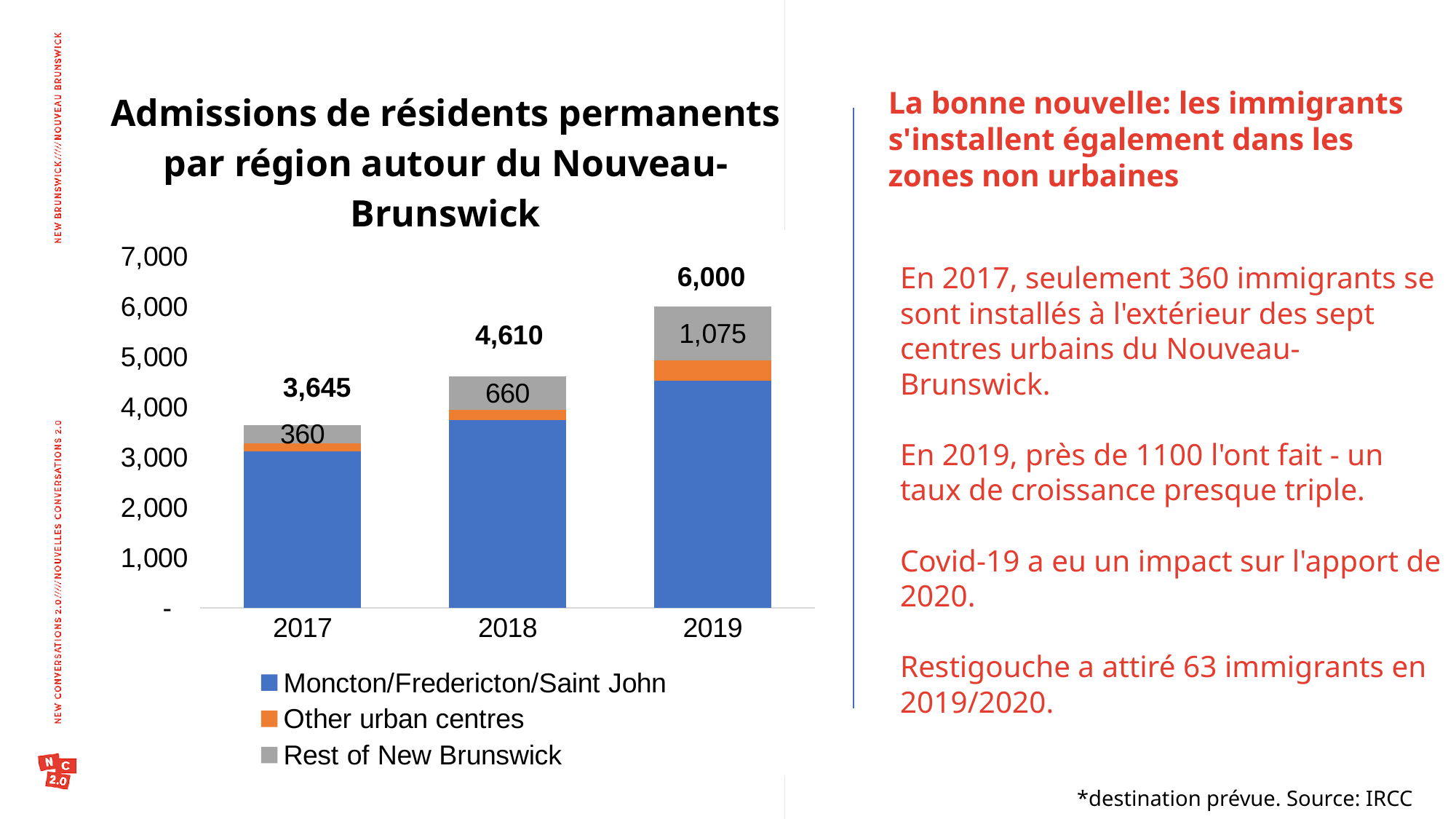
Do the total admissions rise or fall from 2017 to 2019? Rise Which year has the highest total admissions? 2019 What is the value labelled for Rest of New Brunswick in 2018? 660 Is the Moncton/Fredericton/Saint John value for 2019 greater or less than 4,000? greater What is the total value shown above the bar for 2019? 6,000 What is the value labelled for Rest of New Brunswick in 2019? 1,075 How many series does the legend list? 3 What kind of chart is shown on the slide? Stacked bar chart What is the difference between the total for 2019 and the total for 2017? 2,355 What is the total value shown above the bar for 2017? 3,645 Which year has the lowest total admissions? 2017 What is the difference between the Rest of New Brunswick values for 2019 and 2017? 715